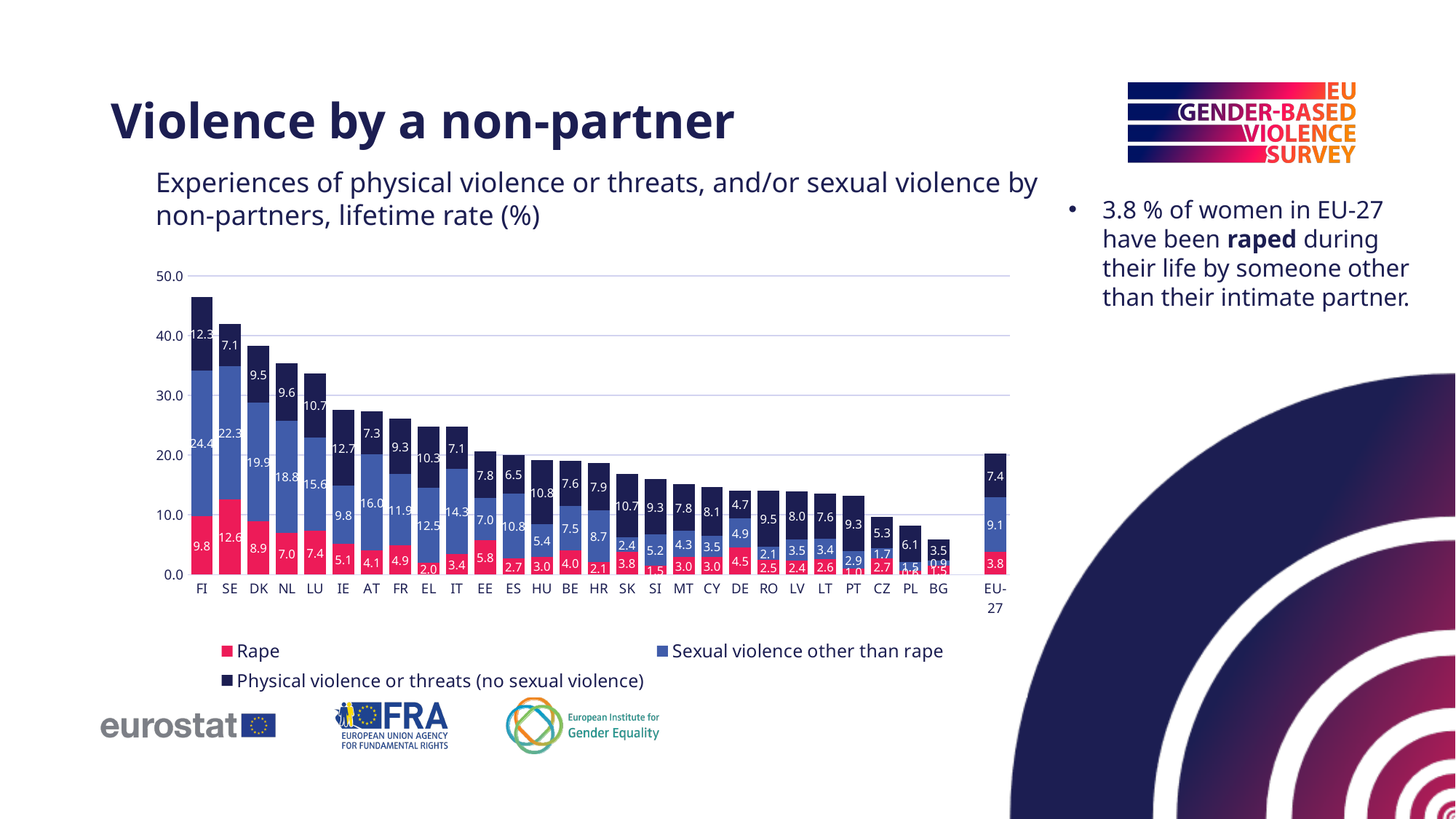
How many series does the legend list? 3 What is the value for Sexual violence other than rape for EU-27? 9.1 What is the Rape value for SE? 12.6 Which country has the highest Rape value? SE Which is larger, the Sexual violence other than rape value for FI or for SE? FI What is the total of the stacked bar for EU-27? 20.3 What is the value for Physical violence or threats (no sexual violence) for IE? 12.7 What is the difference between the Rape values for SE and FI? 2.8 Is the total stacked bar for FI greater or less than 40.0? greater How many categories are shown on the x axis? 28 Which category has the lowest total stacked bar? BG What kind of chart is shown on the slide? Stacked bar chart